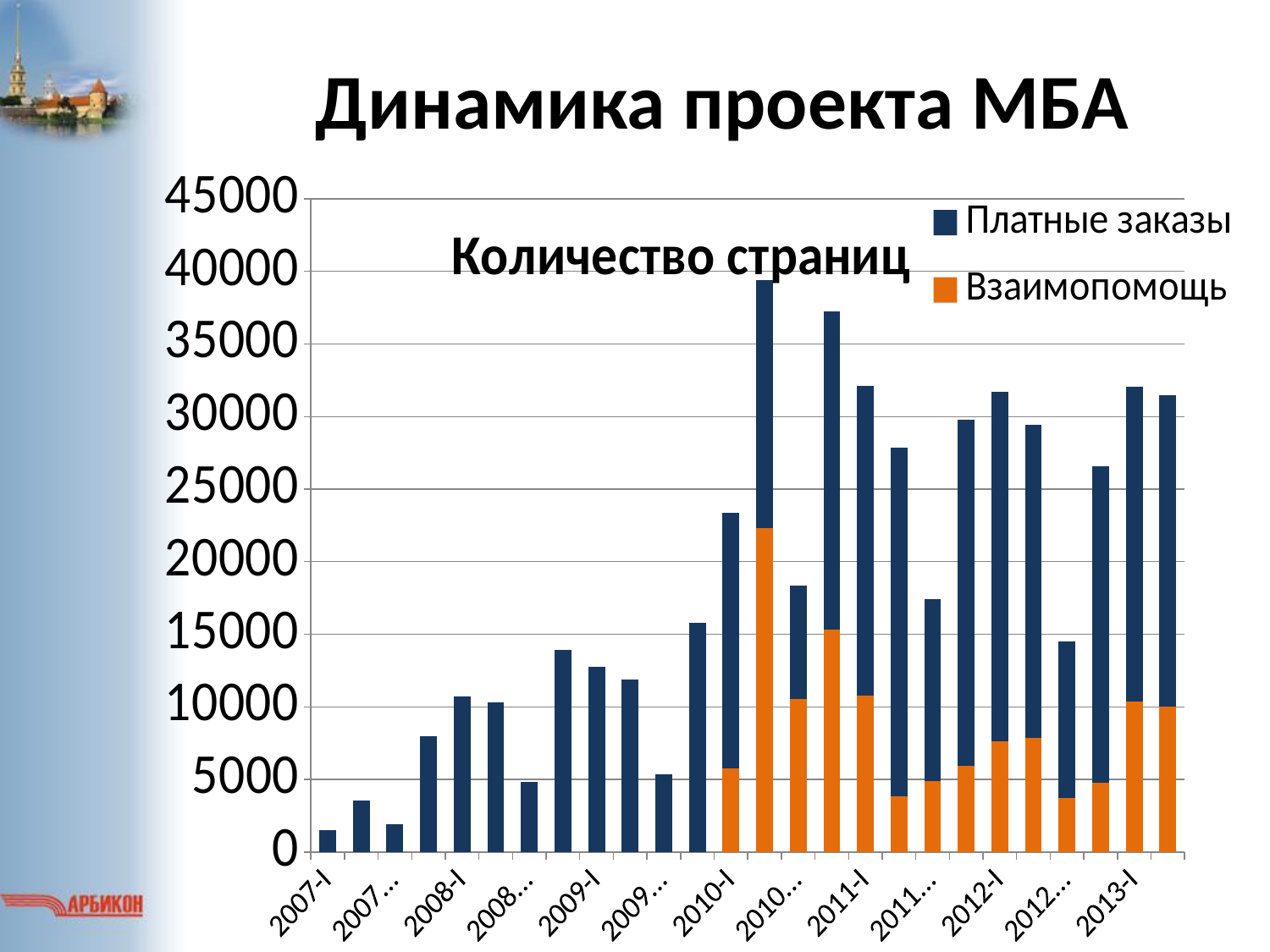
Is the total value for 2013-I greater or less than 30000? greater Is the total value for 2010-I greater or less than 20000? greater Is the total value for 2007-I greater or less than 5000? less What are the two series named in the legend? Платные заказы and Взаимопомощь What is the title printed inside the chart area? Количество страниц How many series does the legend list? 2 What kind of chart is shown on the slide? Stacked bar chart Do the totals generally rise or fall from 2007-I to 2013-I? rise Which has the larger total, 2007-I or 2008-I? 2008-I Which has the larger total, 2009-I or 2010-I? 2010-I